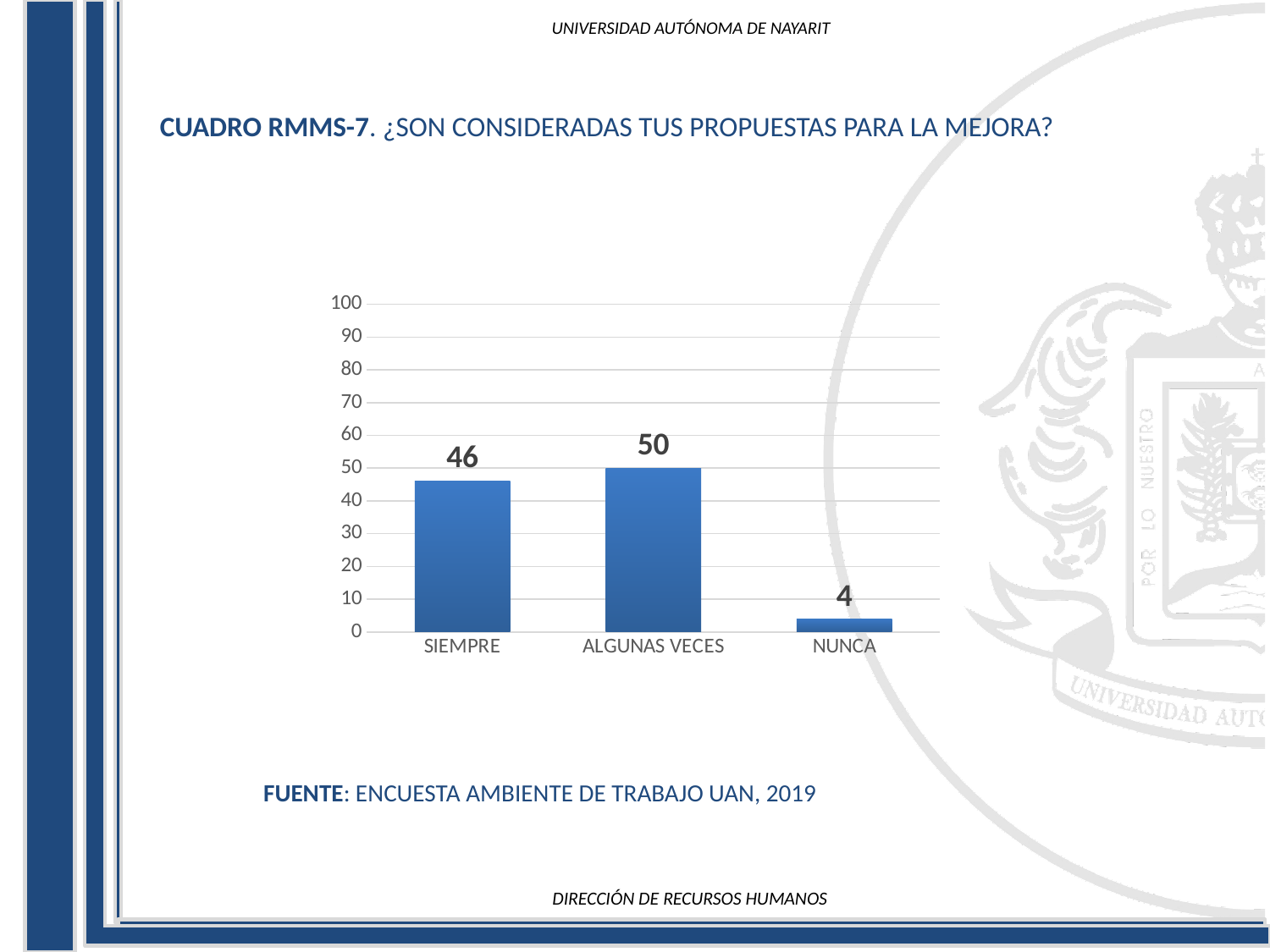
What is the highest value shown on the y axis? 100 What is the difference between the values for SIEMPRE and NUNCA? 42 What is the value for NUNCA? 4 Is the value for SIEMPRE greater or less than 40? greater What is the difference between the values for ALGUNAS VECES and SIEMPRE? 4 Which category has the lowest value? NUNCA How many categories are shown on the x axis? 3 What kind of chart is shown on the slide? bar chart Which is larger, the value for SIEMPRE or the value for NUNCA? SIEMPRE What is the value for ALGUNAS VECES? 50 What is the value for SIEMPRE? 46 Which category has the highest value? ALGUNAS VECES